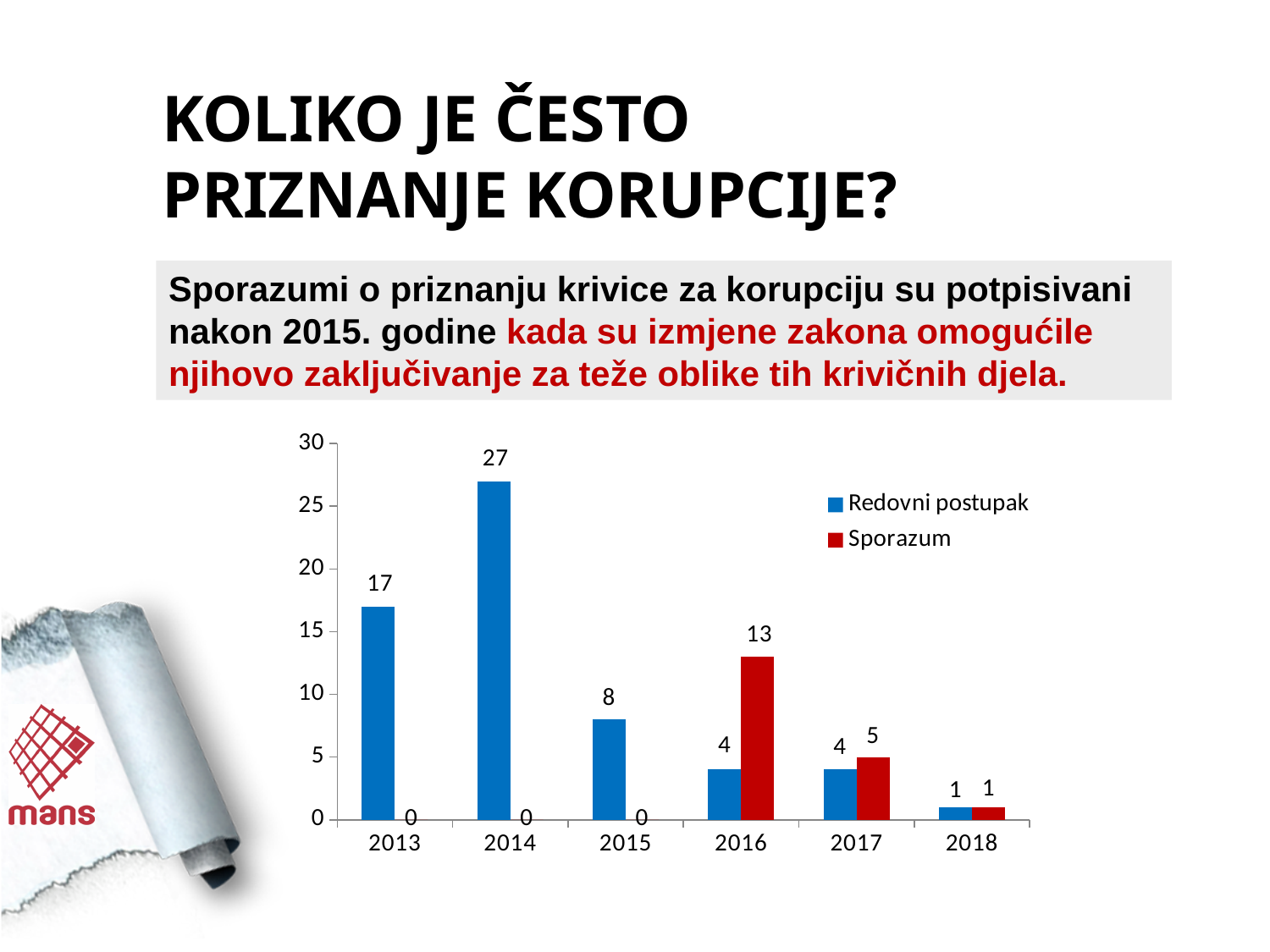
What is the difference between Redovni postupak in 2014 and in 2013? 10 What is the value for Redovni postupak in 2014? 27 How many series does the legend list? 2 How many years are shown on the x axis? 6 In 2017, which is larger: Redovni postupak or Sporazum? Sporazum Which colour represents Sporazum in the chart? Red What kind of chart is shown on the slide? Bar chart What is the value for Sporazum in 2015? 0 What is the value for Sporazum in 2016? 13 Which year has the highest value for Redovni postupak? 2014 Which year has the highest value for Sporazum? 2016 What is the difference between Sporazum and Redovni postupak in 2016? 9